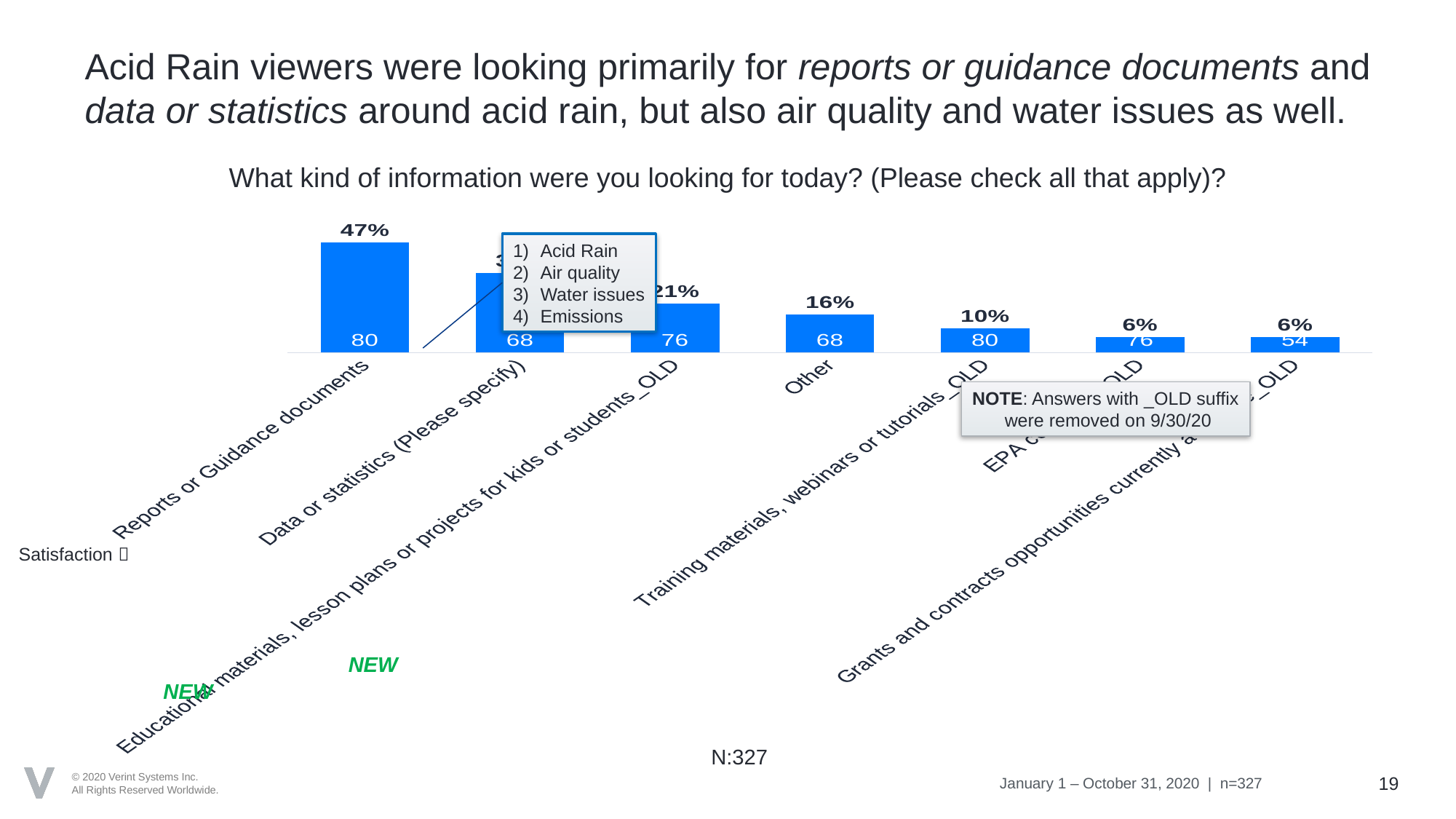
Which category has the highest percentage? Reports or Guidance documents What percentage of viewers were looking for Reports or Guidance documents? 47% What number is printed inside the bar for Reports or Guidance documents? 80 What percentage is shown for Training materials, webinars or tutorials_OLD? 10% How many bars are plotted in the chart? 7 What percentage is shown for the Other category? 16% Do the percentages generally rise or fall from left to right across the chart? fall What kind of chart is shown on the slide? bar chart What percentage is shown for Educational materials, lesson plans or projects for kids or students_OLD? 21% What is the difference in percentage points between Reports or Guidance documents and Other? 31 percentage points What percentage is shown for Grants and contracts opportunities currently available_OLD? 6% Which has a higher percentage: Educational materials, lesson plans or projects for kids or students_OLD or Training materials, webinars or tutorials_OLD? Educational materials, lesson plans or projects for kids or students_OLD